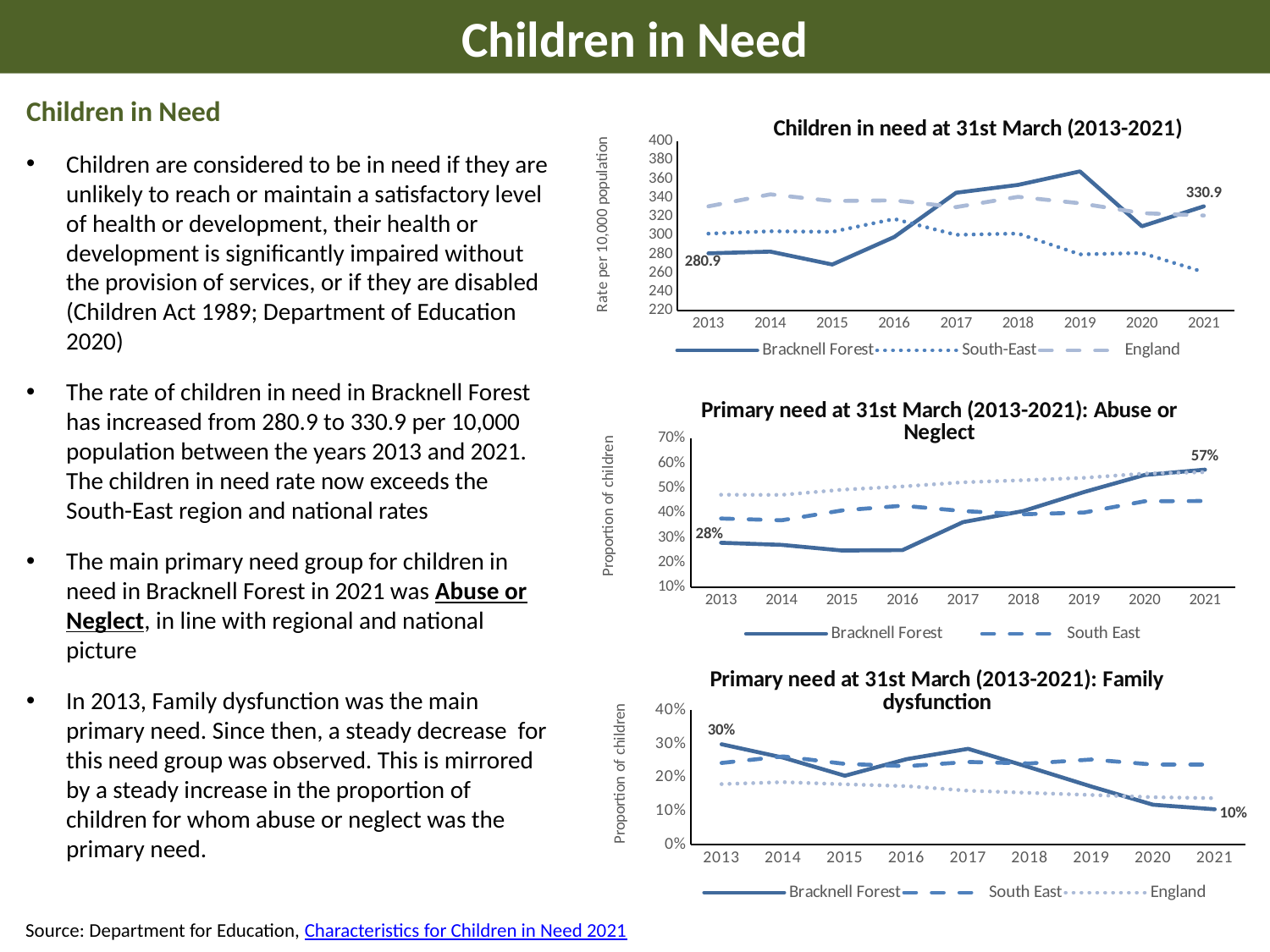
What kind of chart is 'Children in need at 31st March (2013-2021)'? Line chart In the 'Children in need at 31st March (2013-2021)' chart, what is the rate for Bracknell Forest in 2013? 280.9 In the 'Primary need at 31st March (2013-2021): Abuse or Neglect' chart, by how many percentage points did the Bracknell Forest proportion change between 2013 and 2021? 29 percentage points In the 'Primary need at 31st March (2013-2021): Family dysfunction' chart, what is the Bracknell Forest proportion in 2013? 30% How many series does the legend of the 'Children in need at 31st March (2013-2021)' chart list? 3 In the 'Children in need at 31st March (2013-2021)' chart, is the Bracknell Forest value for 2015 greater or less than 280? less In the 'Primary need at 31st March (2013-2021): Family dysfunction' chart, does the Bracknell Forest line rise or fall from 2013 to 2021? Fall In the 'Primary need at 31st March (2013-2021): Abuse or Neglect' chart, what is the Bracknell Forest proportion in 2021? 57% In the 'Primary need at 31st March (2013-2021): Family dysfunction' chart, is the Bracknell Forest value for 2020 greater or less than 20%? less How many years are plotted along the x axis of the 'Children in need at 31st March (2013-2021)' chart? 9 In the 'Children in need at 31st March (2013-2021)' chart, by how much did the Bracknell Forest rate increase between 2013 and 2021? 50 In the 'Children in need at 31st March (2013-2021)' chart, what is the rate for Bracknell Forest in 2021? 330.9